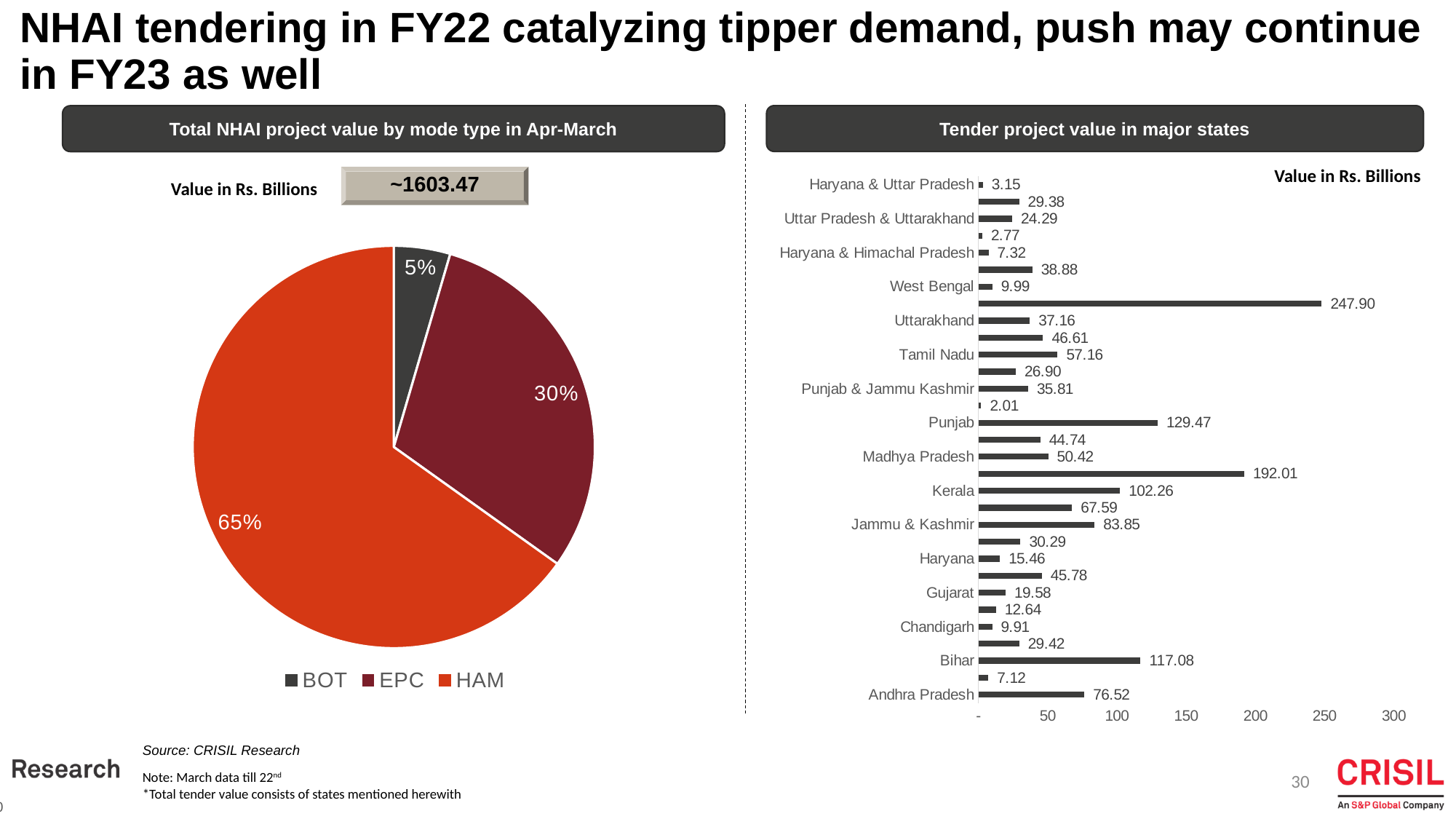
In the 'Tender project value in major states' chart, what is the value for Bihar? 117.08 In the 'Total NHAI project value by mode type in Apr-March' chart, which mode has the largest share? HAM In the 'Tender project value in major states' chart, what is the value for Punjab? 129.47 What total value in Rs. Billions is shown in the box above the 'Total NHAI project value by mode type in Apr-March' chart? ~1603.47 In the 'Tender project value in major states' chart, what is the difference between the values for Punjab and Bihar? 12.39 In the 'Total NHAI project value by mode type in Apr-March' chart, what share does HAM account for? 65% What kind of chart is 'Total NHAI project value by mode type in Apr-March'? Pie chart In the 'Total NHAI project value by mode type in Apr-March' chart, what percentage is shown for EPC? 30% In the 'Total NHAI project value by mode type in Apr-March' chart, which mode has the smallest share? BOT In the 'Tender project value in major states' chart, which has the larger value, Kerala or Andhra Pradesh? Kerala In the 'Total NHAI project value by mode type in Apr-March' chart, how many percentage points larger is HAM's share than EPC's share? 35 percentage points What kind of chart is 'Tender project value in major states'? Bar chart